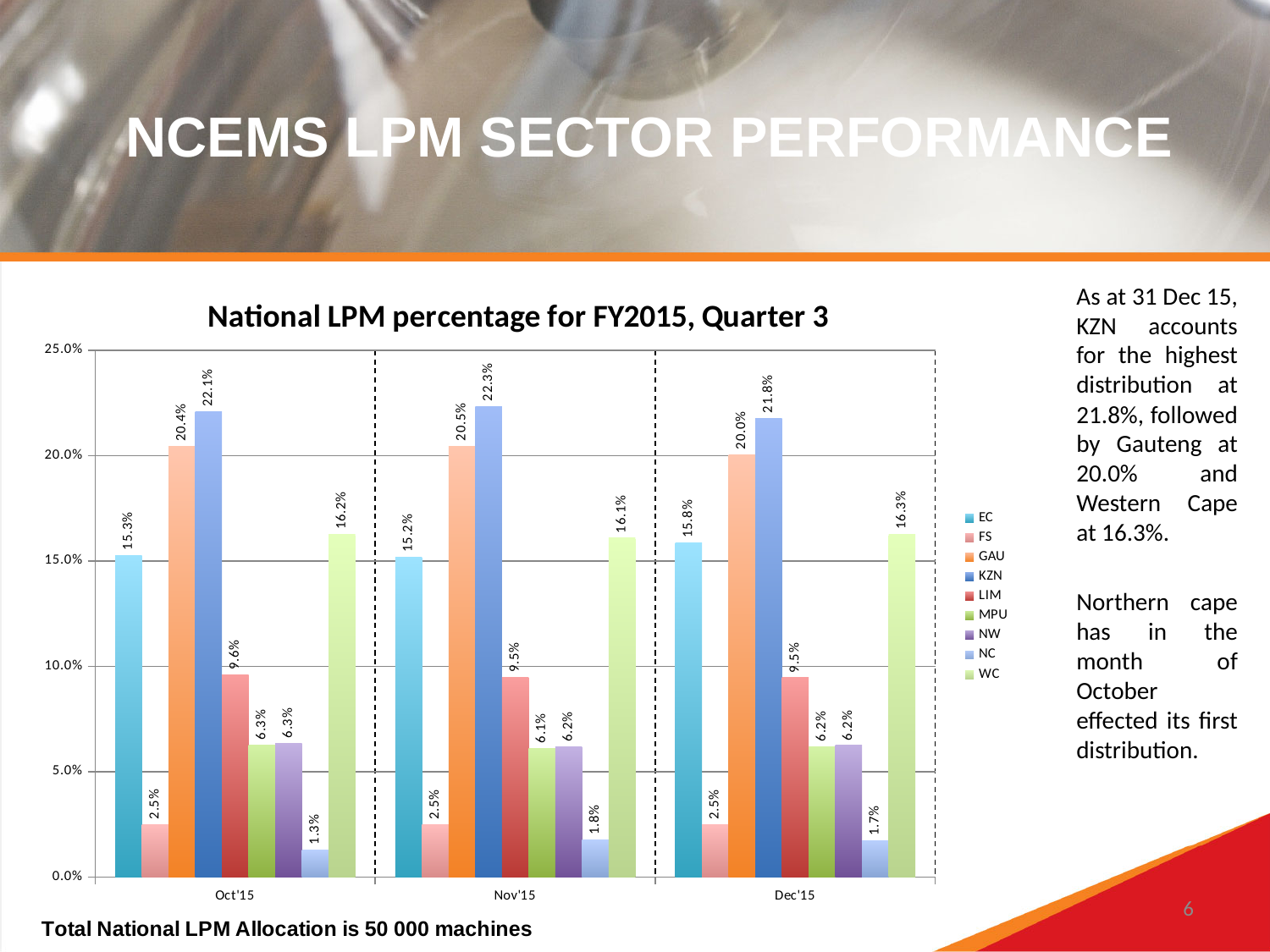
How many series does the legend list? 9 What is the value for GAU in Oct'15? 20.4% What is the value for NC in Nov'15? 1.8% What is the difference between KZN and GAU in Dec'15? 1.8% Which is larger in Oct'15, EC or WC? WC Which province has the lowest value in Oct'15? NC What is the value for WC in Dec'15? 16.3% What kind of chart is shown on the slide? Bar chart Which province has the highest value in Nov'15? KZN Is the value for LIM in Nov'15 greater or less than 10.0%? less What is the value for KZN in Dec'15? 21.8% How many months are shown on the x axis? 3